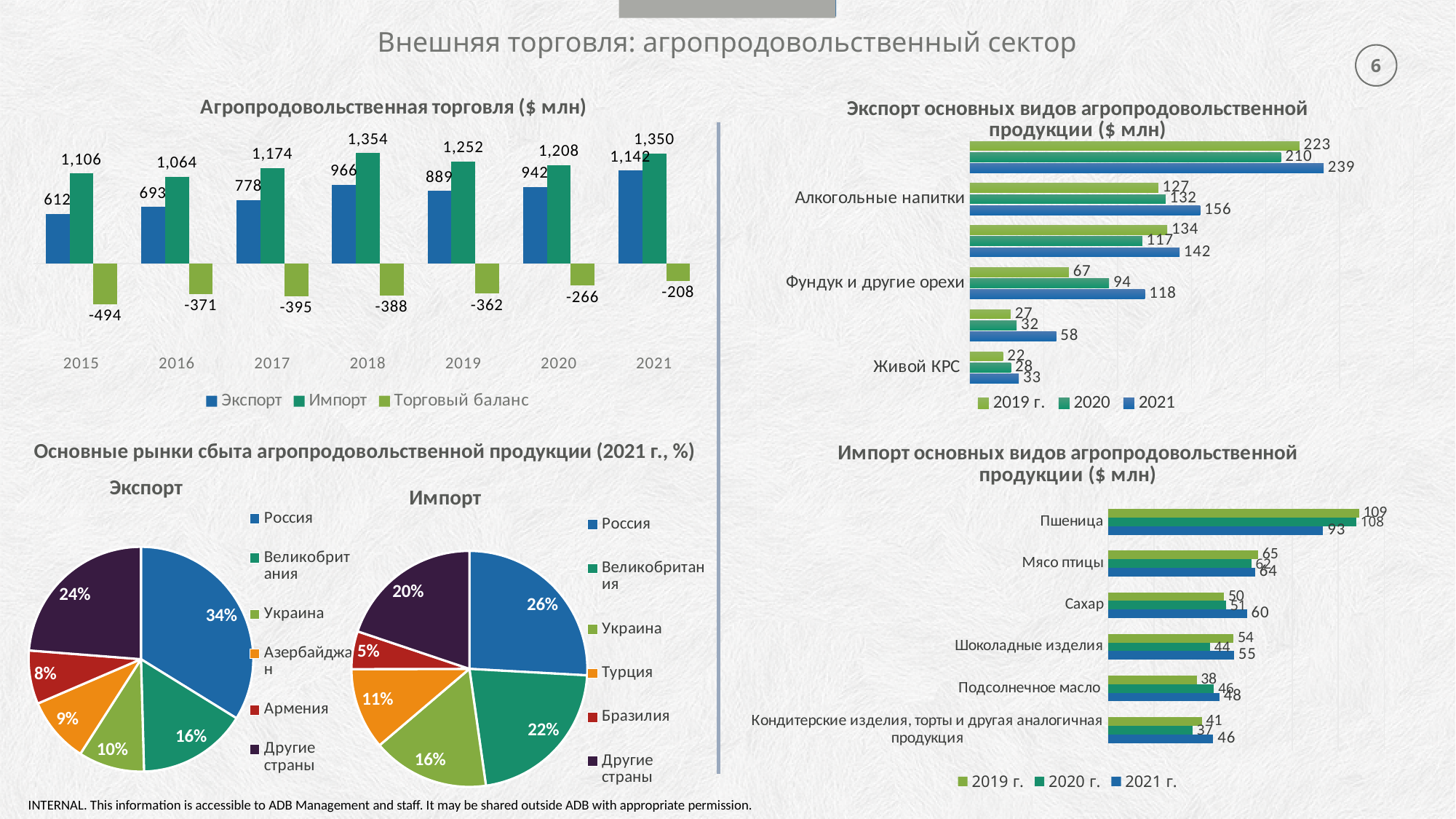
In the chart 'Агропродовольственная торговля ($ млн)', which year has the highest Импорт value? 2018 How many series does the legend of the chart 'Агропродовольственная торговля ($ млн)' list? 3 In the chart 'Экспорт основных видов агропродовольственной продукции ($ млн)', what is the 2019 г. value for Фундук и другие орехи? 67 What kind of chart is 'Импорт основных видов агропродовольственной продукции ($ млн)'? bar chart In the chart 'Импорт основных видов агропродовольственной продукции ($ млн)', what is the 2019 г. value for Пшеница? 109 In the chart 'Экспорт основных видов агропродовольственной продукции ($ млн)', what is the 2021 value for Алкогольные напитки? 156 In the 'Экспорт' pie chart under 'Основные рынки сбыта агропродовольственной продукции (2021 г., %)', what share does Россия have? 34% How many slices does the 'Импорт' pie chart under 'Основные рынки сбыта агропродовольственной продукции (2021 г., %)' have? 6 In the chart 'Агропродовольственная торговля ($ млн)', what is the difference between Импорт and Экспорт in 2015? 494 In the chart 'Экспорт основных видов агропродовольственной продукции ($ млн)', which is larger for Живой КРС: the 2020 value or the 2021 value? 2021 In the chart 'Агропродовольственная торговля ($ млн)', what is the Экспорт value for 2021? 1,142 In the chart 'Агропродовольственная торговля ($ млн)', does the Экспорт value rise or fall from 2015 to 2018? rise